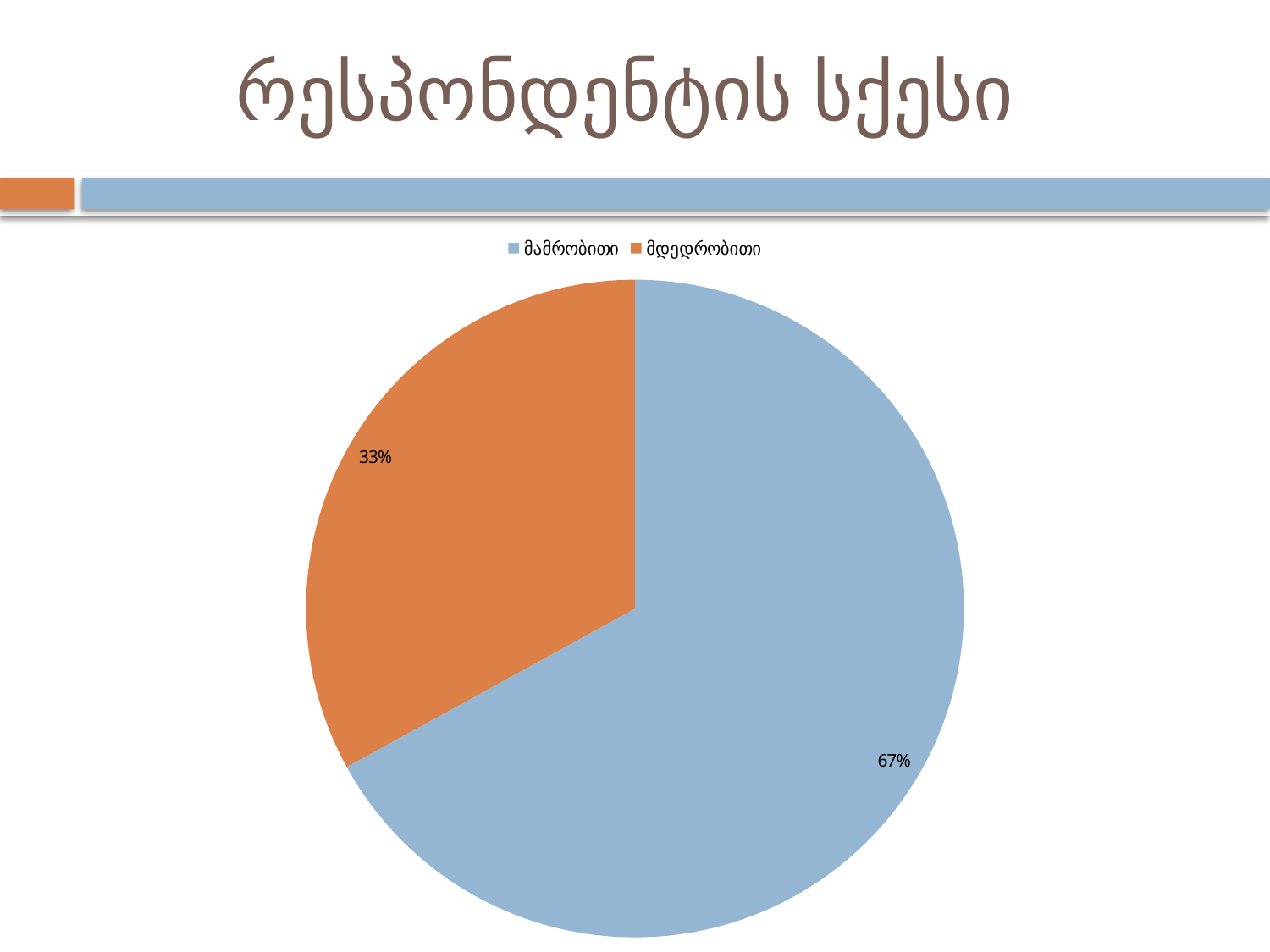
How many slices does the pie chart have? 2 What kind of chart is shown on the slide? pie chart Which category has the smallest slice of the pie? მდედრობითი What is the difference in percentage points between the მამრობითი and მდედრობითი slices? 34 What is the title of the slide? რესპონდენტის სქესი What share of the pie does მდედრობითი take? 33% What share of the pie does მამრობითი take? 67% Which category has the largest slice of the pie? მამრობითი How many entries does the legend list? 2 Which slice is larger, მამრობითი or მდედრობითი? მამრობითი What colour is the მდედრობითი slice? orange